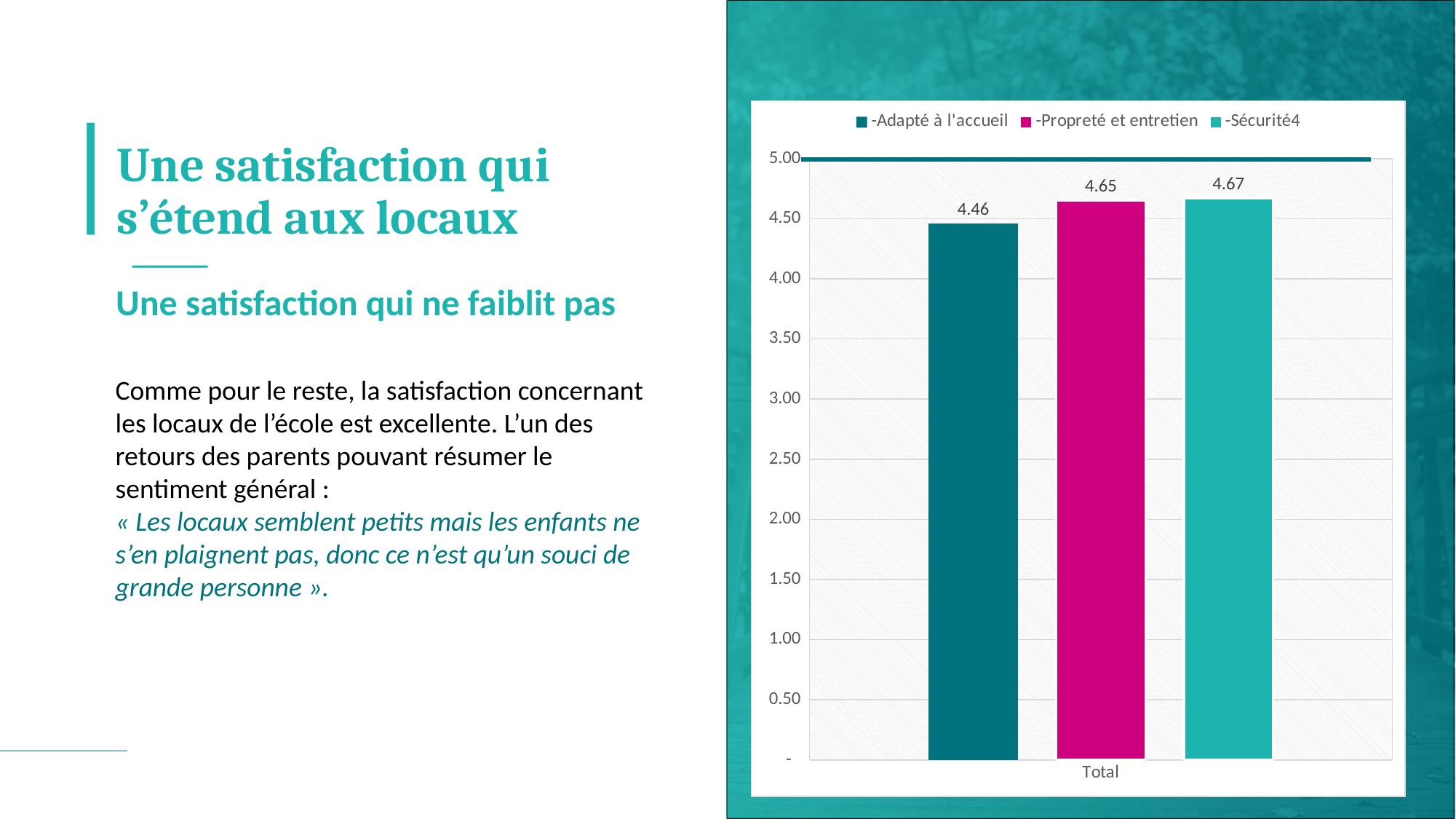
What kind of chart is shown on the slide? bar chart Is the value for Adapté à l'accueil greater or less than 4.50? less What is the value of the Adapté à l'accueil bar? 4.46 What is the value of the Propreté et entretien bar? 4.65 What is the difference between the Sécurité4 value and the Adapté à l'accueil value? 0.21 Which series has the lowest value? Adapté à l'accueil What is the value of the Sécurité4 bar? 4.67 What is the difference between the Propreté et entretien value and the Adapté à l'accueil value? 0.19 What is the label of the category on the x axis? Total Which series has the highest value? Sécurité4 Which is larger, the Propreté et entretien value or the Adapté à l'accueil value? Propreté et entretien How many series does the legend list? 3